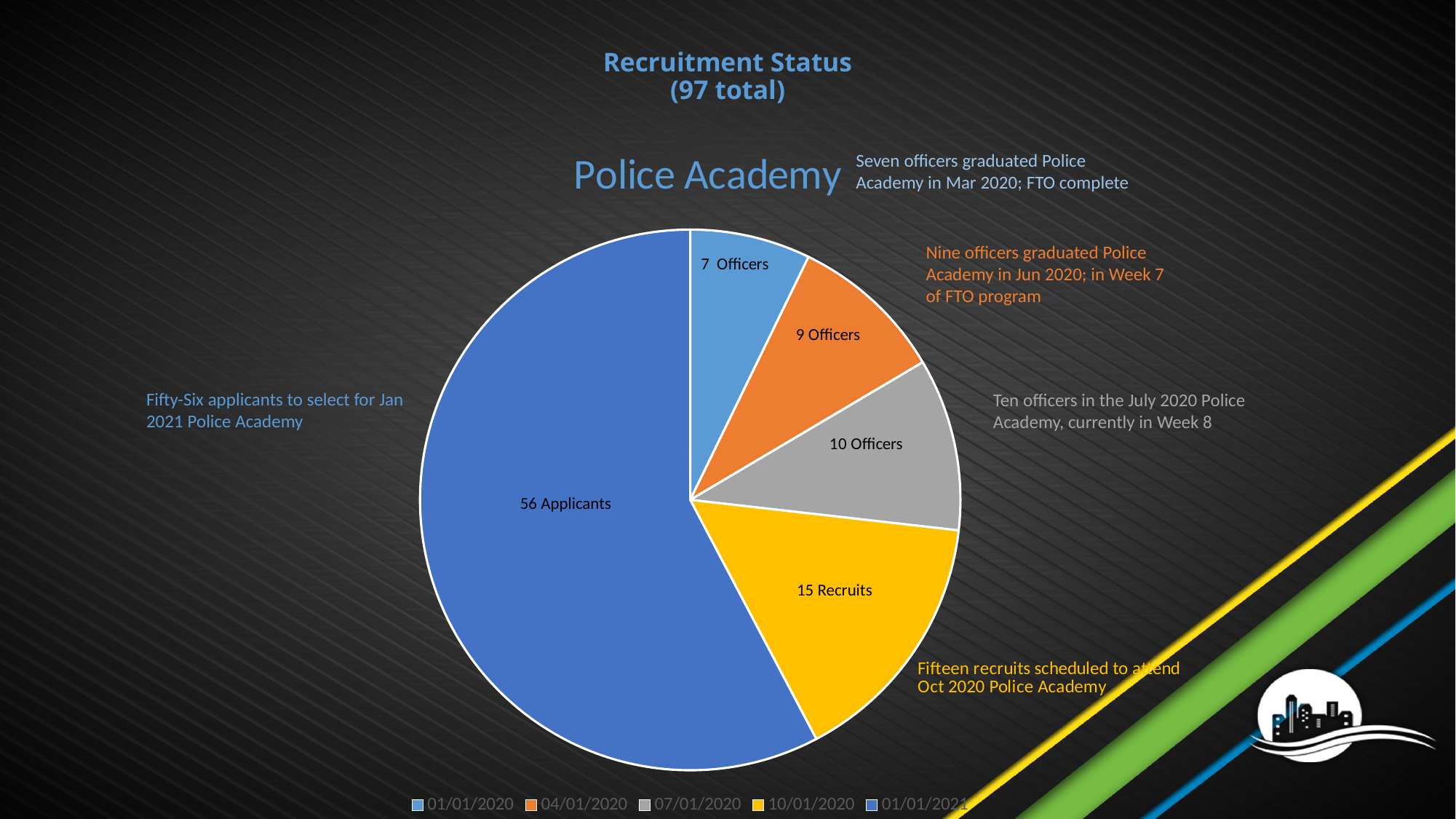
What is the title of the chart? Police Academy How many entries does the legend list? 5 Which is larger, the slice for 04/01/2020 or the slice for 07/01/2020? 07/01/2020 What is the value of the slice for 07/01/2020? 10 Officers What kind of chart is shown on the slide? pie chart What is the difference between the 56 Applicants slice and the 15 Recruits slice? 41 Which legend entry corresponds to the smallest slice? 01/01/2020 How many slices does the pie chart have? 5 What is the total of all slices in the pie chart? 97 Which legend entry corresponds to the largest slice? 01/01/2021 What is the value of the slice for 01/01/2021? 56 Applicants What is the value of the slice for 10/01/2020? 15 Recruits